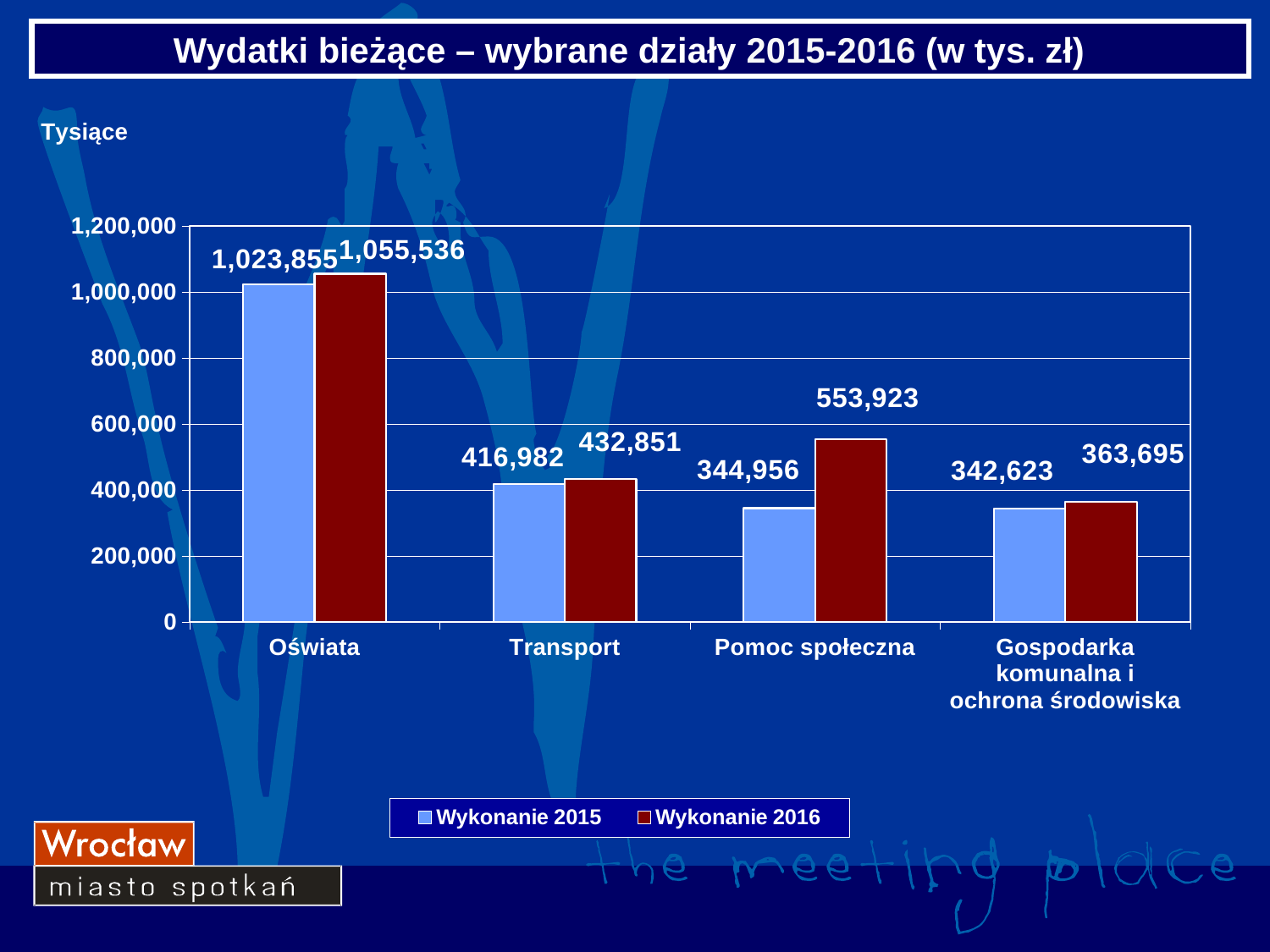
What is the difference between the Wykonanie 2016 and Wykonanie 2015 values for Pomoc społeczna? 208,967 What type of chart is shown on the slide? bar chart How many categories are shown on the x axis? 4 Which category has the lowest Wykonanie 2015 value? Gospodarka komunalna i ochrona środowiska Which is larger: the Wykonanie 2016 value for Transport or the Wykonanie 2016 value for Pomoc społeczna? Pomoc społeczna What is the difference between the Wykonanie 2016 and Wykonanie 2015 values for Oświata? 31,681 What is the Wykonanie 2015 value for Oświata? 1,023,855 Which category has the highest Wykonanie 2016 value? Oświata What is the Wykonanie 2016 value for Pomoc społeczna? 553,923 What is the Wykonanie 2015 value for Transport? 416,982 How many series does the legend list? 2 What is the Wykonanie 2016 value for Gospodarka komunalna i ochrona środowiska? 363,695